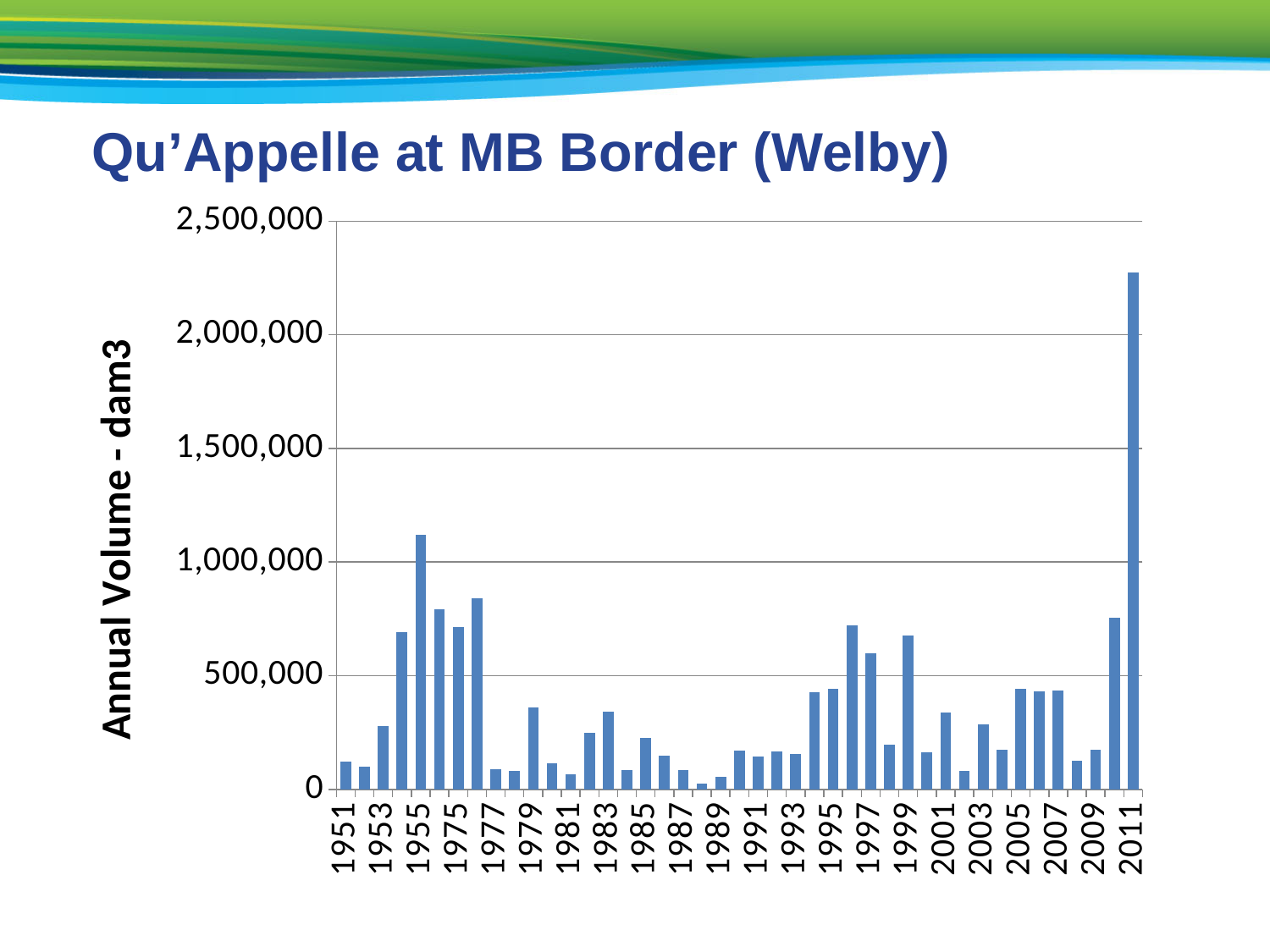
Which year has the larger annual volume, 1955 or 1976? 1955 What is the title of the chart? Qu'Appelle at MB Border (Welby) Which year has the lowest annual volume? 1988 Is the value for 1953 greater or less than 500,000? less Is the value for 1979 greater or less than 500,000? less Which year has the highest annual volume? 2011 Is the value for 1996 greater or less than 500,000? greater What is the label on the vertical axis? Annual Volume - dam3 Which year has the larger annual volume, 2011 or 1955? 2011 What kind of chart is shown on the slide? Bar chart